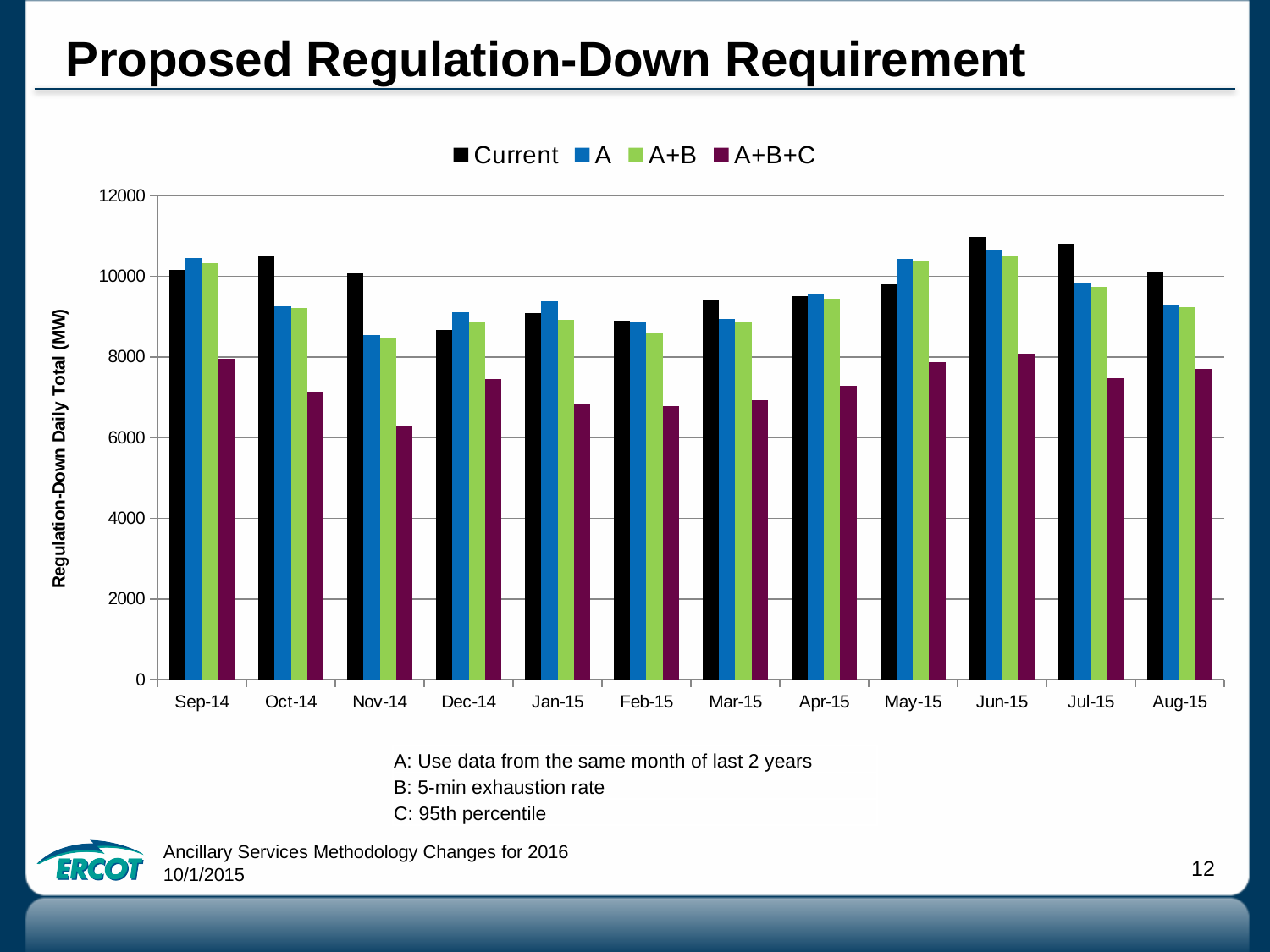
How many series does the legend list? 4 Is the A+B+C value for Sep-14 greater or less than 6000? greater Which month has the highest Current value? Jun-15 Is the A+B+C value for Nov-14 greater or less than 8000? less Is the Current value for Dec-14 greater or less than 10000? less Which month has the lowest A+B+C value? Nov-14 For Dec-14, which is larger: the Current value or the A value? A How many months are shown along the x axis? 12 For Nov-14, which is larger: the Current value or the A value? Current What kind of chart is shown on the slide? bar chart What is the title of the y axis? Regulation-Down Daily Total (MW)